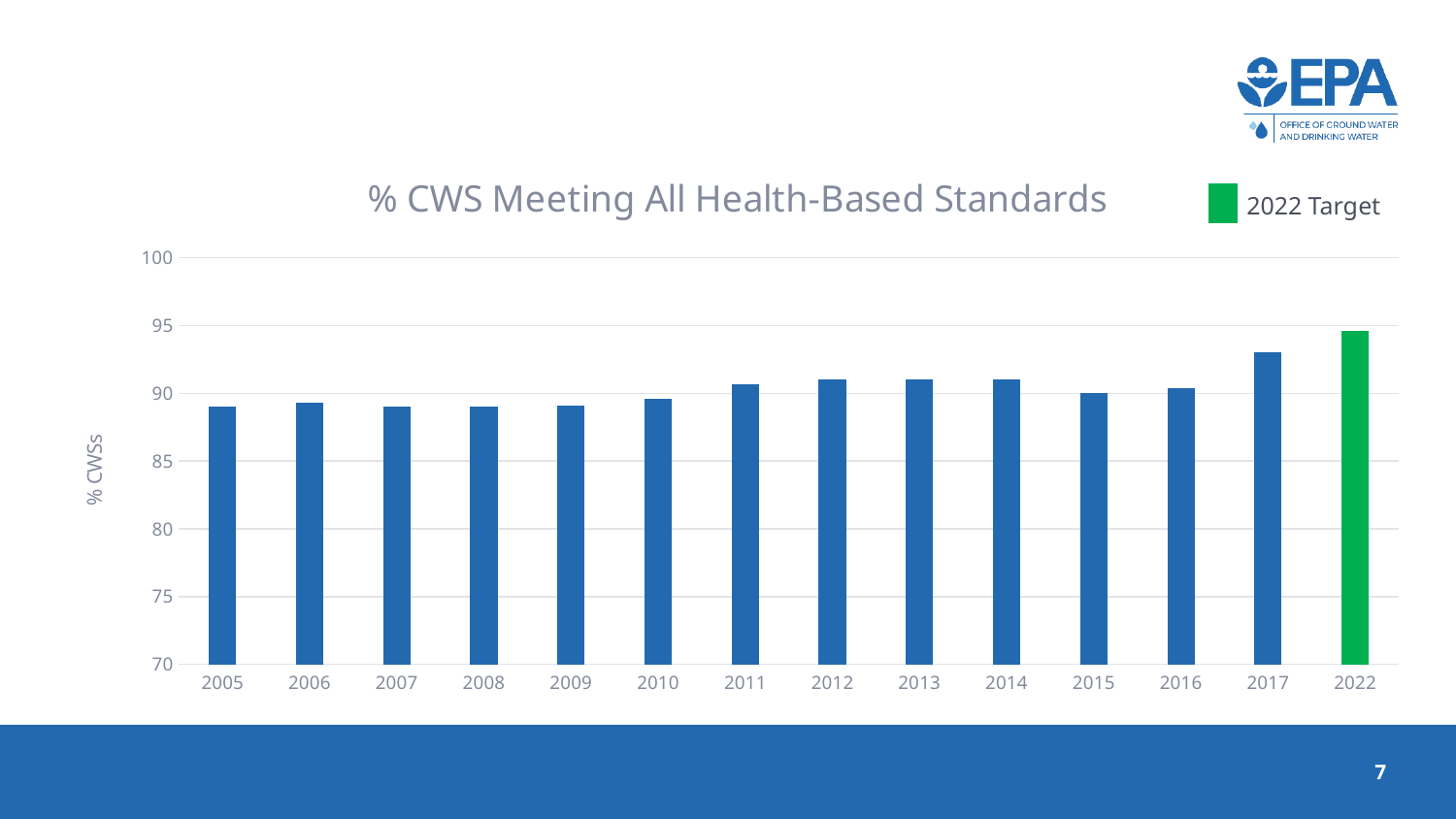
Is the value for 2012 greater or less than 90? greater What is the title of the chart? % CWS Meeting All Health-Based Standards Is the value for 2017 greater or less than 90? greater What does the green bar represent according to the legend? 2022 Target Do the values generally rise or fall from 2005 to 2022? rise Which is larger, the value for 2017 or the value for 2015? 2017 Which year has the highest value in the chart? 2022 Is the value for 2005 greater or less than 90? less How many bars are plotted in the chart? 14 Which is larger, the value for 2022 or the value for 2017? 2022 What type of chart is shown on the slide? bar chart